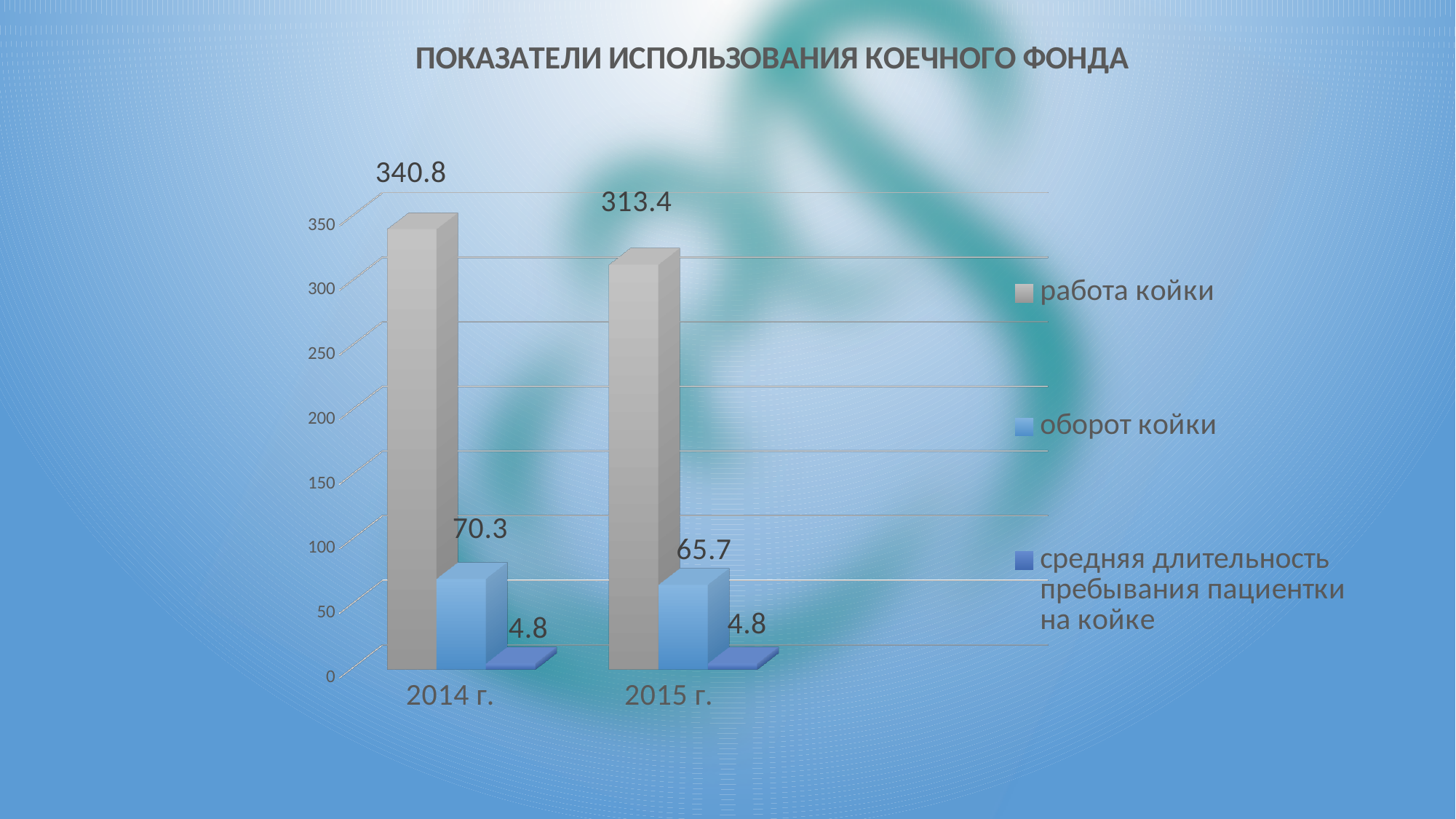
Which year has the higher value for 'работа койки'? 2014 г. What is the value of 'работа койки' for 2014 г.? 340.8 What is the value of 'оборот койки' for 2014 г.? 70.3 Does 'работа койки' rise or fall from 2014 г. to 2015 г.? fall What is the difference between 'оборот койки' in 2014 г. and 2015 г.? 4.6 What type of chart is shown on the slide? bar chart How many categories (years) are shown on the x axis? 2 What is the value of 'средняя длительность пребывания пациентки на койке' for 2015 г.? 4.8 What is the value of 'оборот койки' for 2015 г.? 65.7 What is the value of 'работа койки' for 2015 г.? 313.4 By how much did 'работа койки' change from 2014 г. to 2015 г.? 27.4 How many series does the legend list? 3